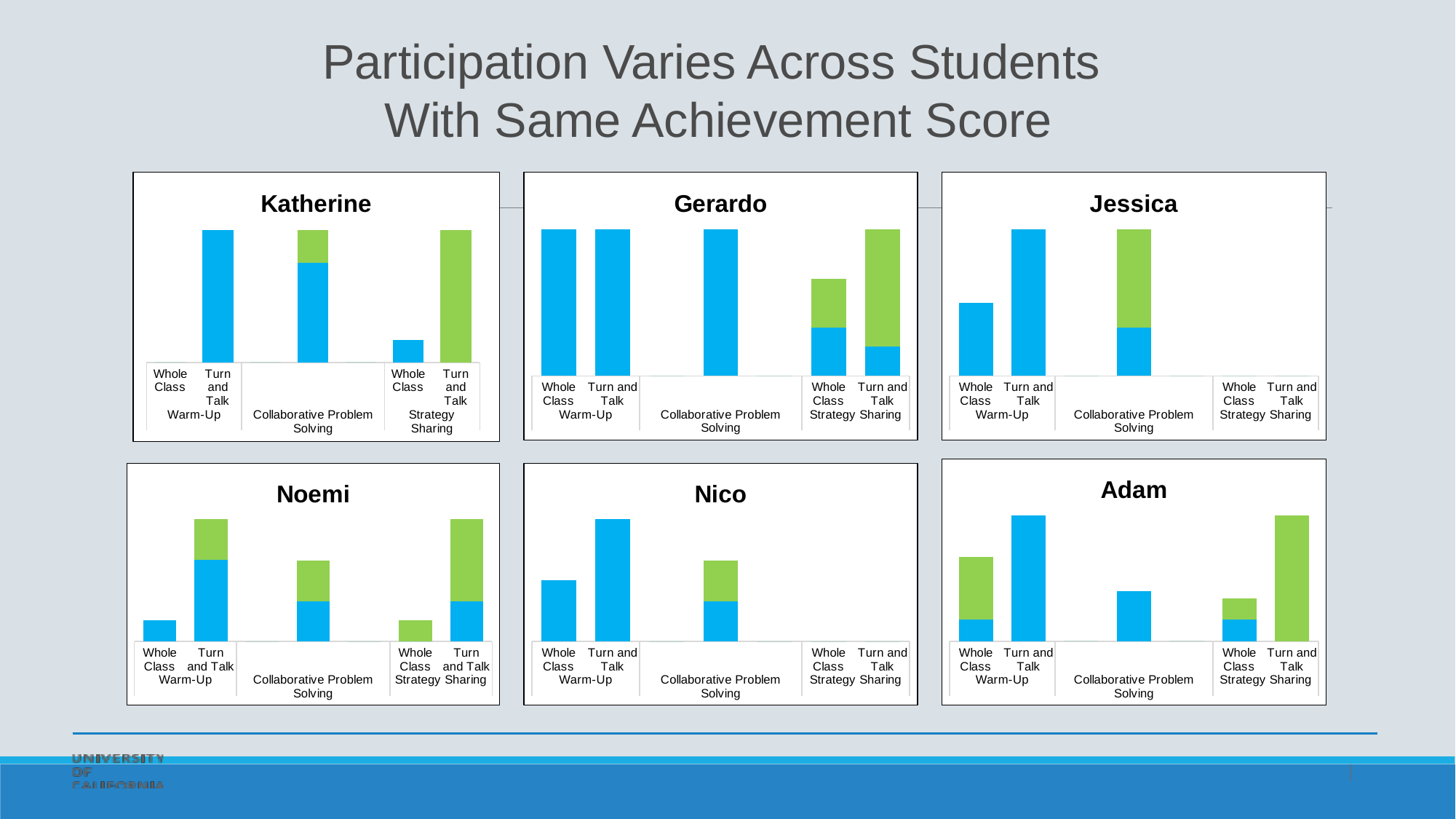
In the Adam chart, which is taller: the Whole Class Warm-Up bar or the Whole Class Strategy Sharing bar? Whole Class Warm-Up In the Jessica chart, which activity group has no bars at all? Strategy Sharing What kind of chart is used for each student on this slide? Stacked bar chart In the Nico chart, which is taller: the Turn and Talk Warm-Up bar or the Collaborative Problem Solving bar? Turn and Talk Warm-Up How many student charts are shown on the slide? 6 How many bar positions (activity categories) does the Katherine chart have along its x axis? 5 In the Jessica chart, which is taller: the Whole Class Warm-Up bar or the Turn and Talk Warm-Up bar? Turn and Talk Warm-Up Which students' charts are shown in the top row of the slide? Katherine, Gerardo, Jessica In the Katherine chart, which category has the shortest non-empty bar? Whole Class Strategy Sharing In the Gerardo chart, which category has the shortest bar? Whole Class Strategy Sharing